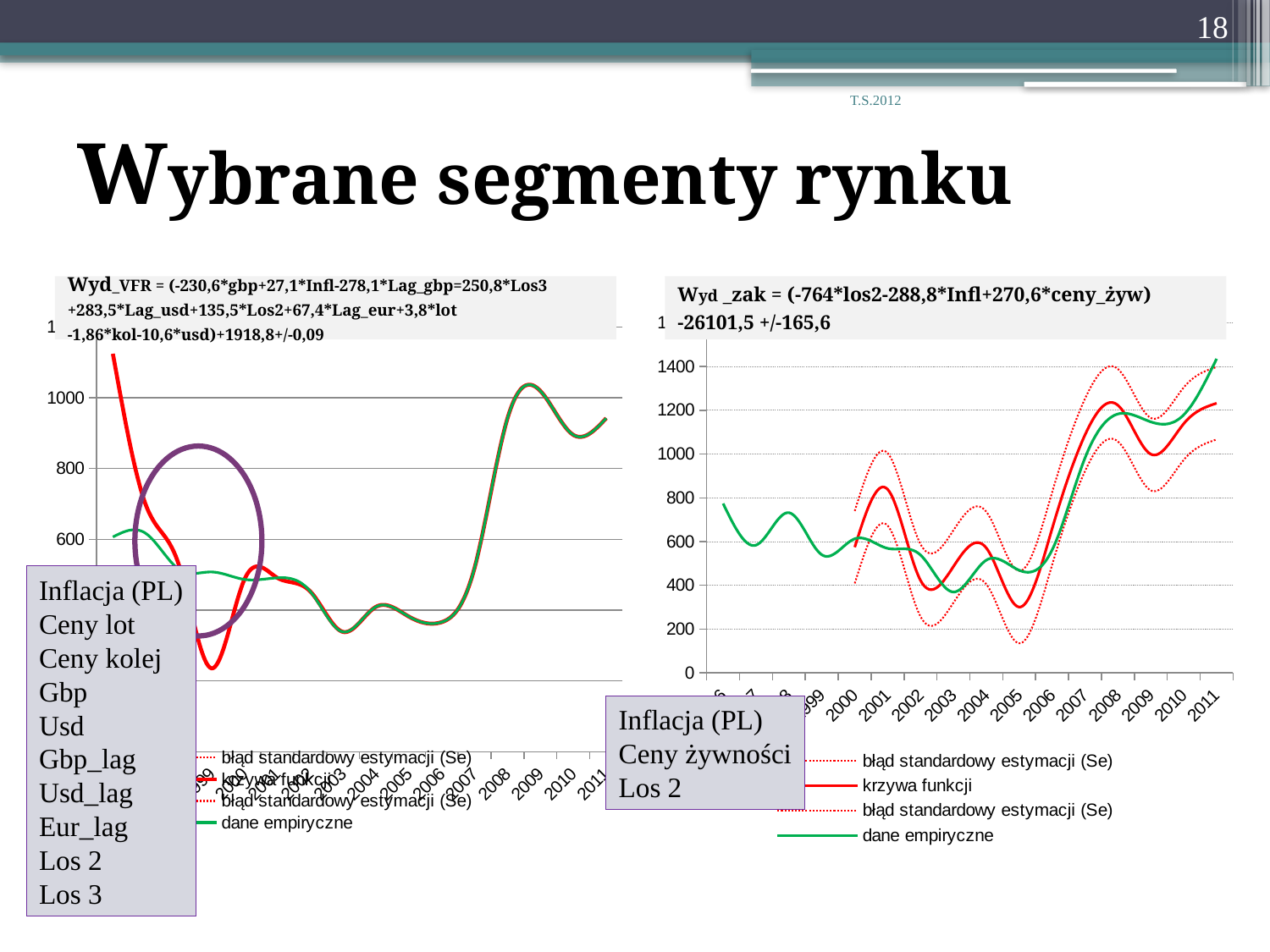
In the right chart (Wyd_zak), which legend entry do the dotted lines represent? błąd standardowy estymacji (Se) In the left chart (Wyd_VFR), does the 'dane empiryczne' line rise or fall between 2007 and 2009? rise How many series does the legend of the left chart (Wyd_VFR) list? 4 What kind of chart is the left chart (Wyd_VFR)? line chart In the right chart (Wyd_zak), is the 'dane empiryczne' value in 2005 greater or less than 600? less How many series does the legend of the right chart (Wyd_zak) list? 4 In the left chart (Wyd_VFR), is the 'dane empiryczne' value in 2009 greater or less than 1000? greater In the right chart (Wyd_zak), does the 'dane empiryczne' line rise or fall between 2006 and 2008? rise In the right chart (Wyd_zak), what colour is the 'krzywa funkcji' line? red In the right chart (Wyd_zak), is the 'krzywa funkcji' value in 2005 greater or less than 400? less What kind of chart is the right chart (Wyd_zak)? line chart